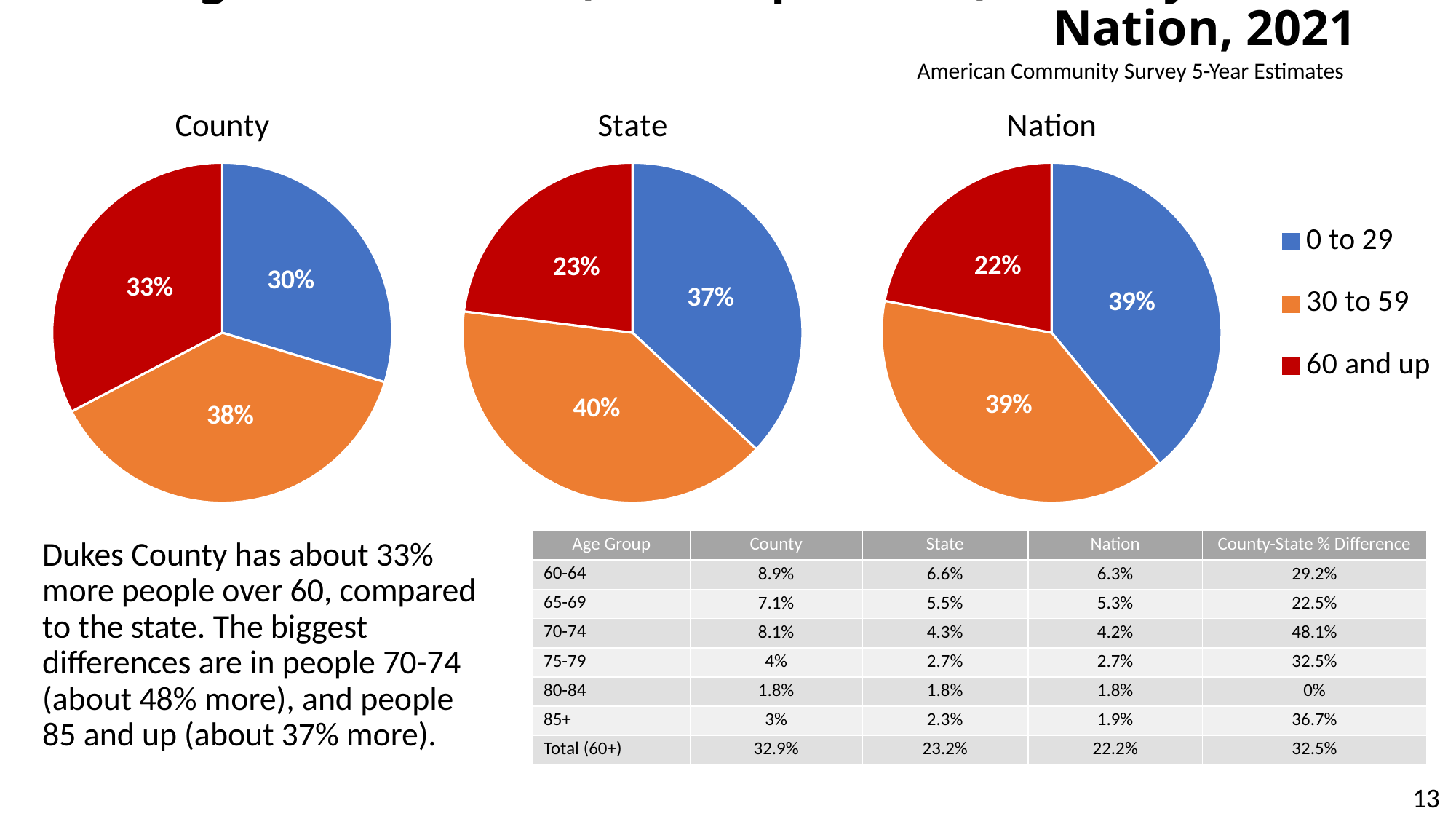
What kind of chart is the County chart? Pie chart Is the 0 to 29 slice larger in the County pie chart or the Nation pie chart? Nation In the Nation pie chart, which age group has the smallest slice? 60 and up In the State pie chart, what share is the 30 to 59 slice? 40% In the County pie chart, what share is the 60 and up slice? 33% How many entries does the legend list? 3 Which colour represents the 30 to 59 age group in the pie charts? Orange In the Nation pie chart, what share is the 0 to 29 slice? 39% How many slices does the State pie chart have? 3 In the State pie chart, which age group has the smallest slice? 60 and up In the County pie chart, which age group has the largest slice? 30 to 59 What is the difference between the 60 and up share in the County pie chart and the 60 and up share in the State pie chart? 10%